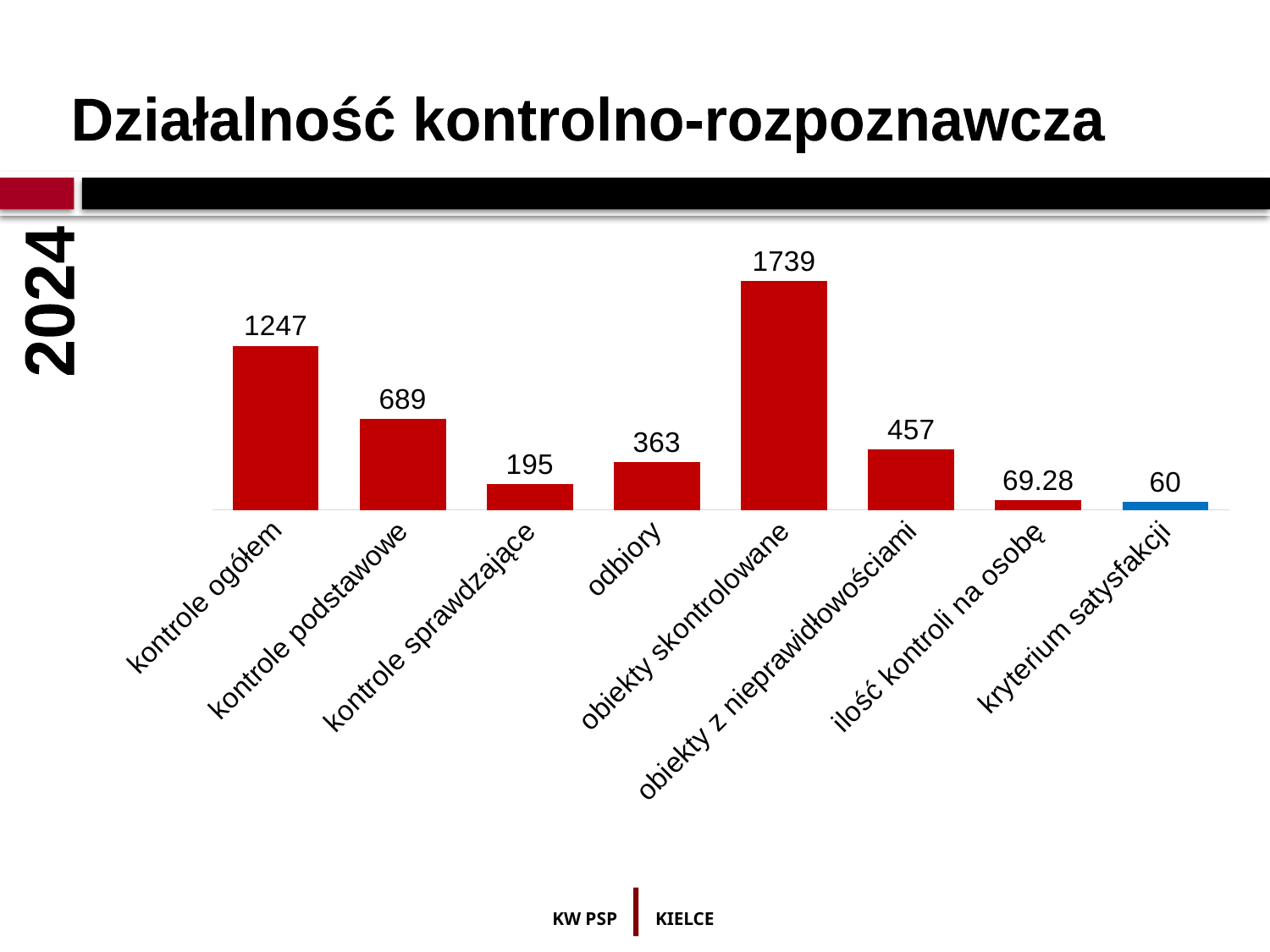
What is the difference between "kontrole ogółem" and "kontrole podstawowe"? 558 How many categories are shown on the chart? 8 What is the value for "kontrole ogółem"? 1247 What is the value for "obiekty z nieprawidłowościami"? 457 Which category has the lowest value? kryterium satysfakcji Which is larger, "odbiory" or "kontrole sprawdzające"? odbiory Which bar is shown in a different colour (blue) from the others? kryterium satysfakcji What kind of chart is shown on the slide? bar chart What is the value for "kryterium satysfakcji"? 60 What is the difference between "obiekty skontrolowane" and "obiekty z nieprawidłowościami"? 1282 What is the value for "ilość kontroli na osobę"? 69.28 Which category has the highest value? obiekty skontrolowane